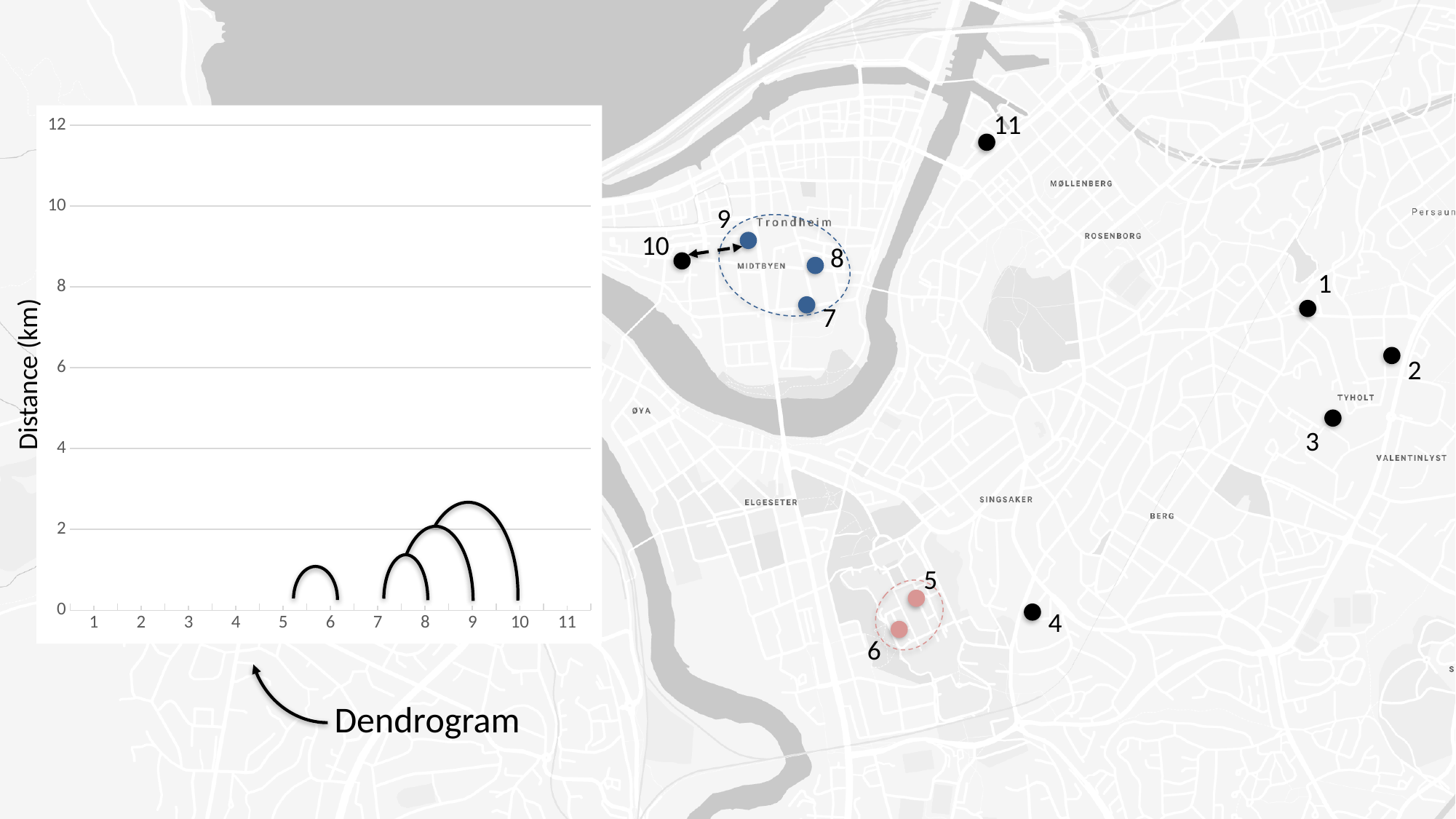
Is the distance at which points 5 and 6 merge greater or less than 2 km? less How many of the numbered points on the x-axis are not connected by any arc in the dendrogram? 5 Which merge happens at a greater distance: points 5 and 6, or points 7 and 8? 7 and 8 Is the distance at which points 7 and 8 merge greater or less than 2 km? less Which point joins the dendrogram at the highest distance? 10 Is the distance at which point 10 joins the cluster greater or less than 2 km? greater What kind of chart is shown on the left of the slide? Dendrogram What is the highest value shown on the y-axis of the dendrogram? 12 What is the label of the y-axis of the dendrogram? Distance (km) How many numbered points are listed along the x-axis of the dendrogram? 11